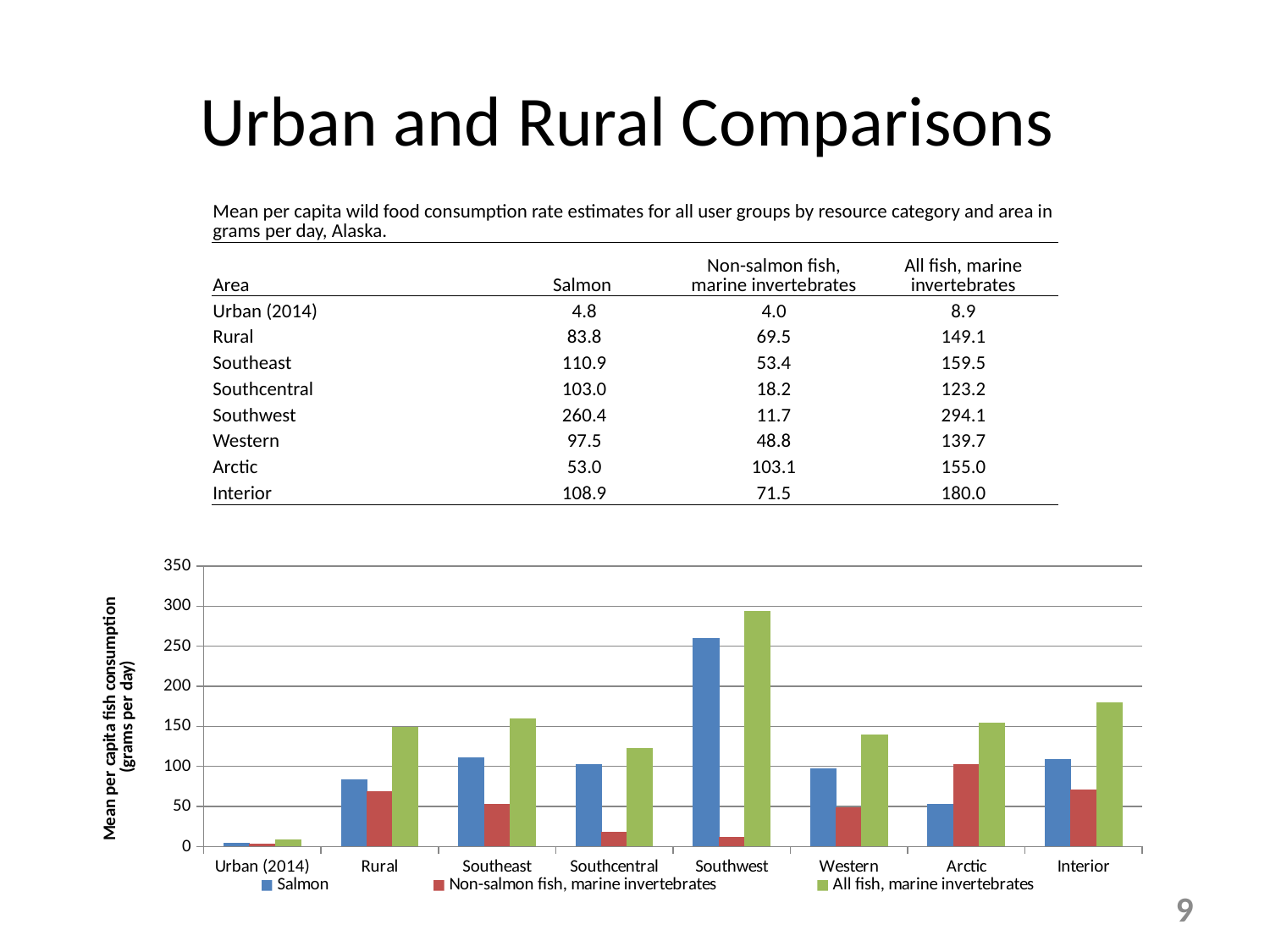
How many areas are shown along the x axis of the chart? 8 Which area has the highest Salmon value? Southwest Is the All fish, marine invertebrates value for Southwest greater or less than 250? greater What kind of chart is shown on the slide? bar chart What is the All fish, marine invertebrates value for Interior? 180.0 How many series does the chart legend list? 3 Which area has the lowest value for All fish, marine invertebrates? Urban (2014) Is the Salmon value for Arctic greater or less than 100? less Which area has the highest value for Non-salmon fish, marine invertebrates? Arctic What is the Salmon value for Southwest, in grams per day? 260.4 Which is larger for Arctic: the Salmon value or the Non-salmon fish, marine invertebrates value? Non-salmon fish, marine invertebrates What is the difference between the Salmon values for Southwest and Rural? 176.6